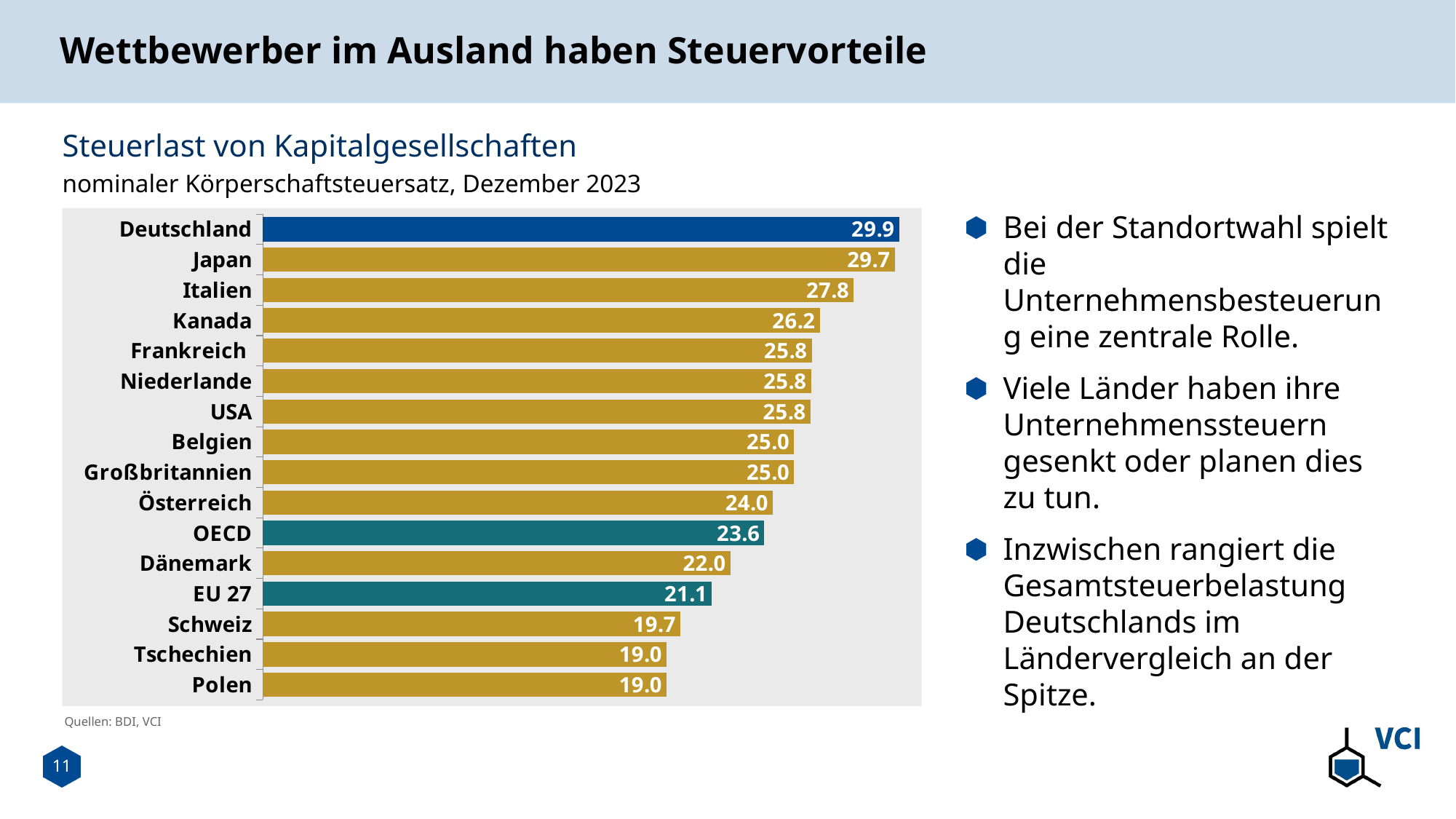
What is the value for Polen? 19.0 Which category has the highest value? Deutschland What is the value for OECD? 23.6 How many categories are shown in the chart? 16 What is the value for Deutschland? 29.9 What kind of chart is shown on the slide? bar chart What is the difference between the values for Japan and Italien? 1.9 Which is larger, the value for Österreich or the value for Belgien? Belgien Which is larger, the value for Kanada or the value for Dänemark? Kanada What is the title of the chart? Steuerlast von Kapitalgesellschaften What is the difference between the values for Deutschland and EU 27? 8.8 What is the value for Schweiz? 19.7